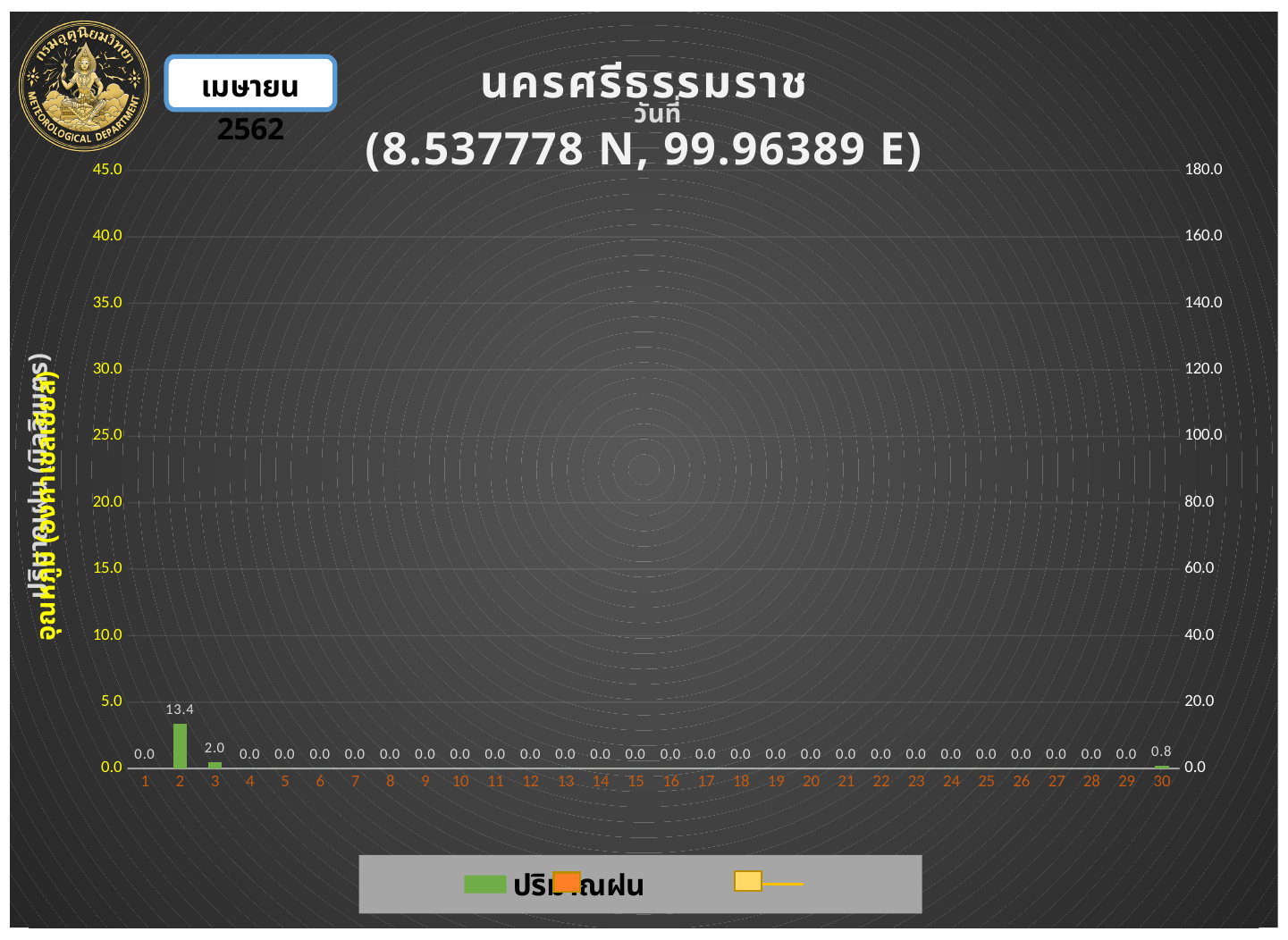
What colour are the rainfall bars? green What type of chart is used to show the rainfall values? bar chart What is the rainfall value shown for day 30? 0.8 Which day has the highest rainfall value? 2 What is the highest value shown on the right-hand axis? 180.0 How many days are shown on the x axis? 30 What is the rainfall value shown for day 15? 0.0 What is the rainfall value shown for day 3? 2.0 Which has the larger rainfall value, day 3 or day 30? day 3 What is the rainfall value shown for day 2? 13.4 What is the difference between the rainfall values for day 2 and day 3? 11.4 What is the difference between the rainfall values for day 2 and day 30? 12.6